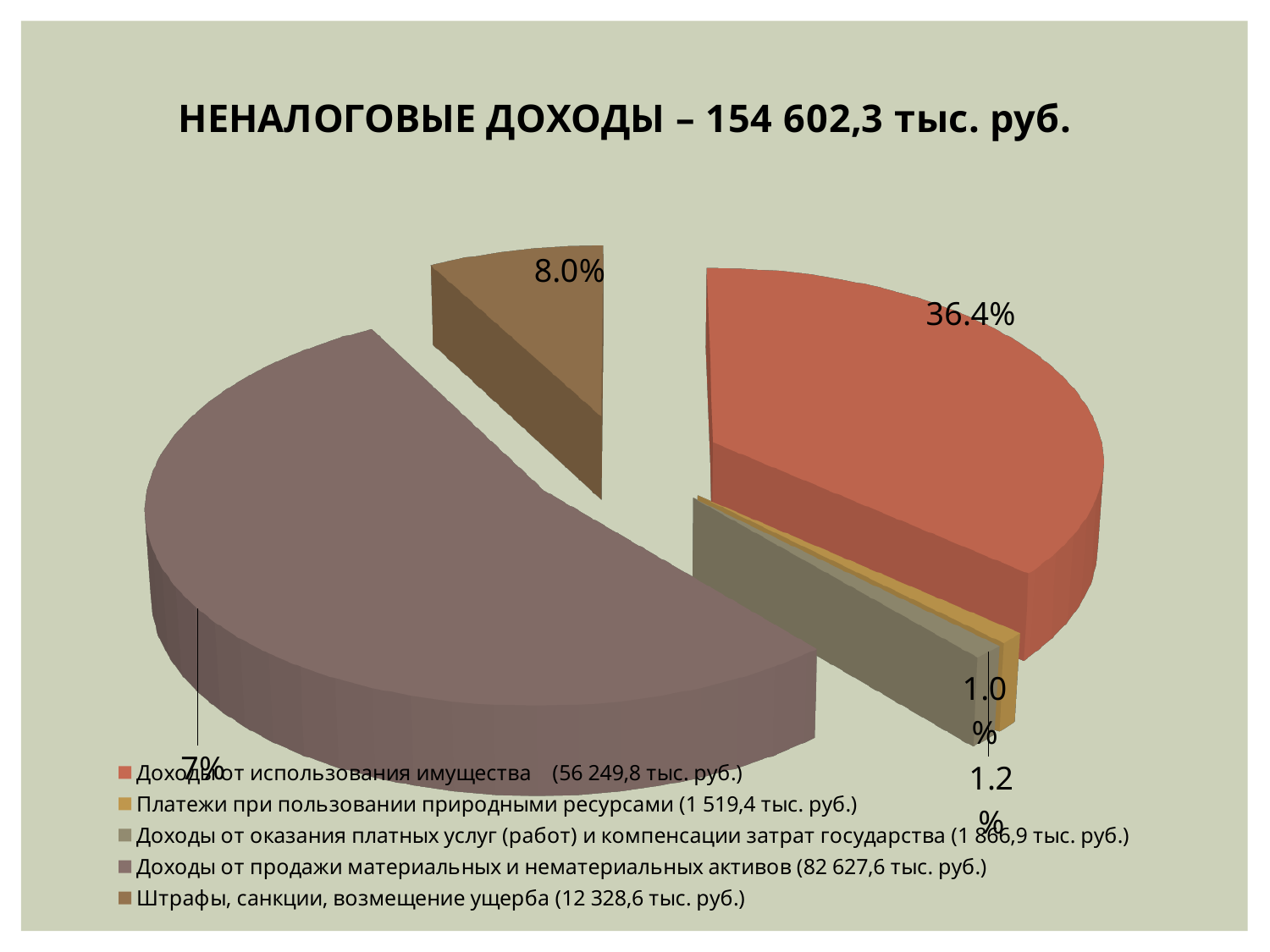
What share of the pie is labelled for Доходы от оказания платных услуг (работ) и компенсации затрат государства? 1.2% What share of the pie is labelled for Доходы от использования имущества? 36.4% According to the legend, what amount is given for Штрафы, санкции, возмещение ущерба? 12 328,6 тыс. руб. Which category has the smallest slice of the pie? Платежи при пользовании природными ресурсами Which category has the largest slice of the pie? Доходы от продажи материальных и нематериальных активов What share of the pie is labelled for Штрафы, санкции, возмещение ущерба? 8.0% How many slices does the pie chart have? 5 What kind of chart is shown on the slide? Pie chart Which slice is larger: Доходы от использования имущества or Штрафы, санкции, возмещение ущерба? Доходы от использования имущества By how many percentage points does the share for Доходы от использования имущества exceed the share for Штрафы, санкции, возмещение ущерба? 28.4 percentage points What total amount of non-tax revenue is stated in the chart title? 154 602,3 тыс. руб. What share of the pie is labelled for Платежи при пользовании природными ресурсами? 1.0%